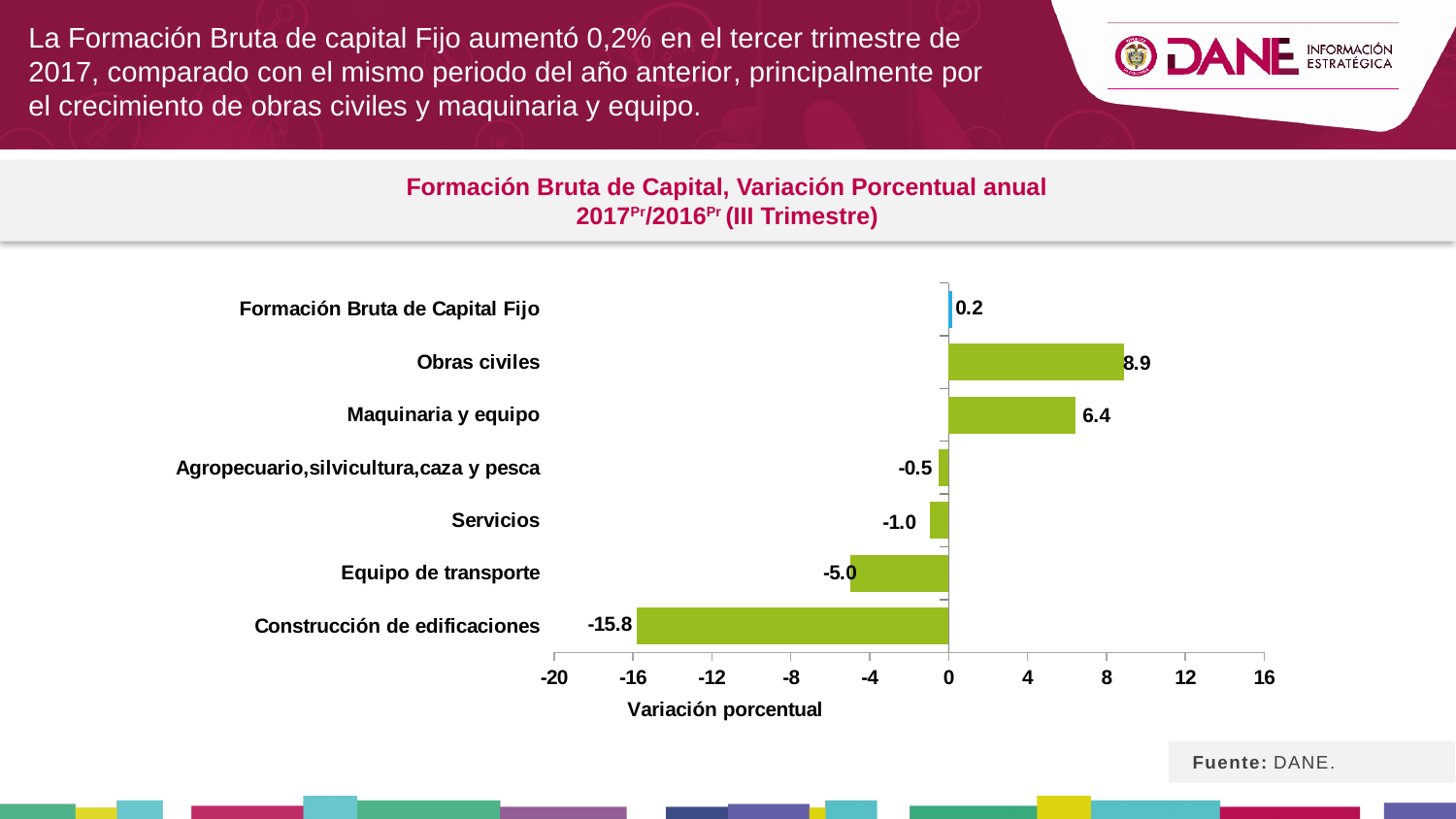
What kind of chart is shown on the slide? Bar chart Which category has the lowest value? Construcción de edificaciones What is the value for Obras civiles? 8.9 What is the difference between the values for Obras civiles and Maquinaria y equipo? 2.5 Which is larger, the value for Servicios or the value for Equipo de transporte? Servicios Is the value for Construcción de edificaciones greater or less than -12? less What is the value for Maquinaria y equipo? 6.4 Which category has the highest value? Obras civiles What is the value for Construcción de edificaciones? -15.8 What is the value for Formación Bruta de Capital Fijo? 0.2 How many categories are shown in the chart? 7 What is the label of the horizontal axis? Variación porcentual